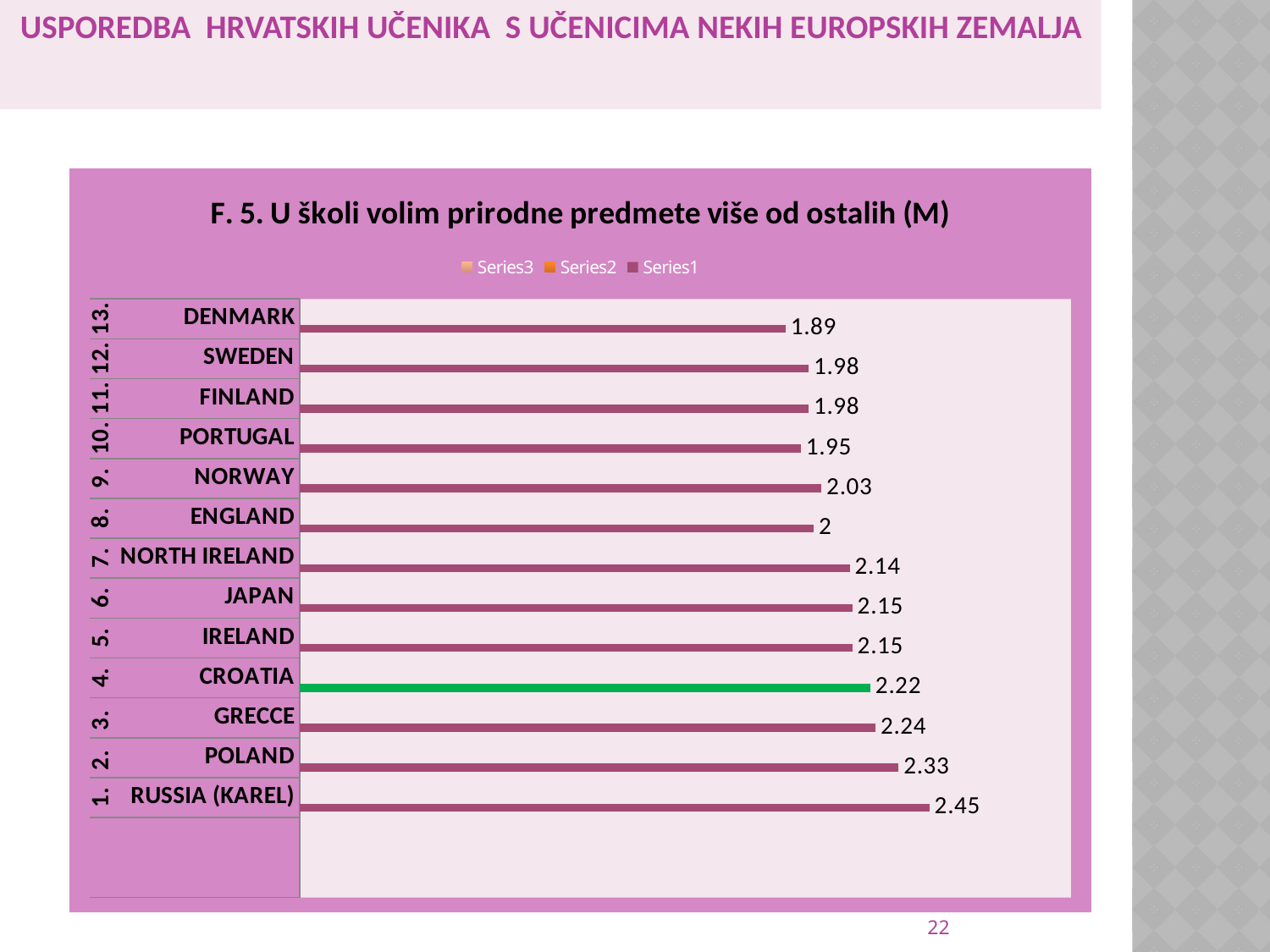
How many series does the legend list? 3 What is the value for RUSSIA (KAREL)? 2.45 Which country has the lowest value? DENMARK What is the title of the chart? F. 5. U školi volim prirodne predmete više od ostalih (M) How many countries are shown in the chart? 13 What kind of chart is this? bar chart Which country's bar is coloured green? CROATIA Which has a larger value, GRECCE or NORWAY? GRECCE What is the value for DENMARK? 1.89 What is the difference between the values for POLAND and CROATIA? 0.11 Which country has the highest value? RUSSIA (KAREL) What is the value for CROATIA? 2.22